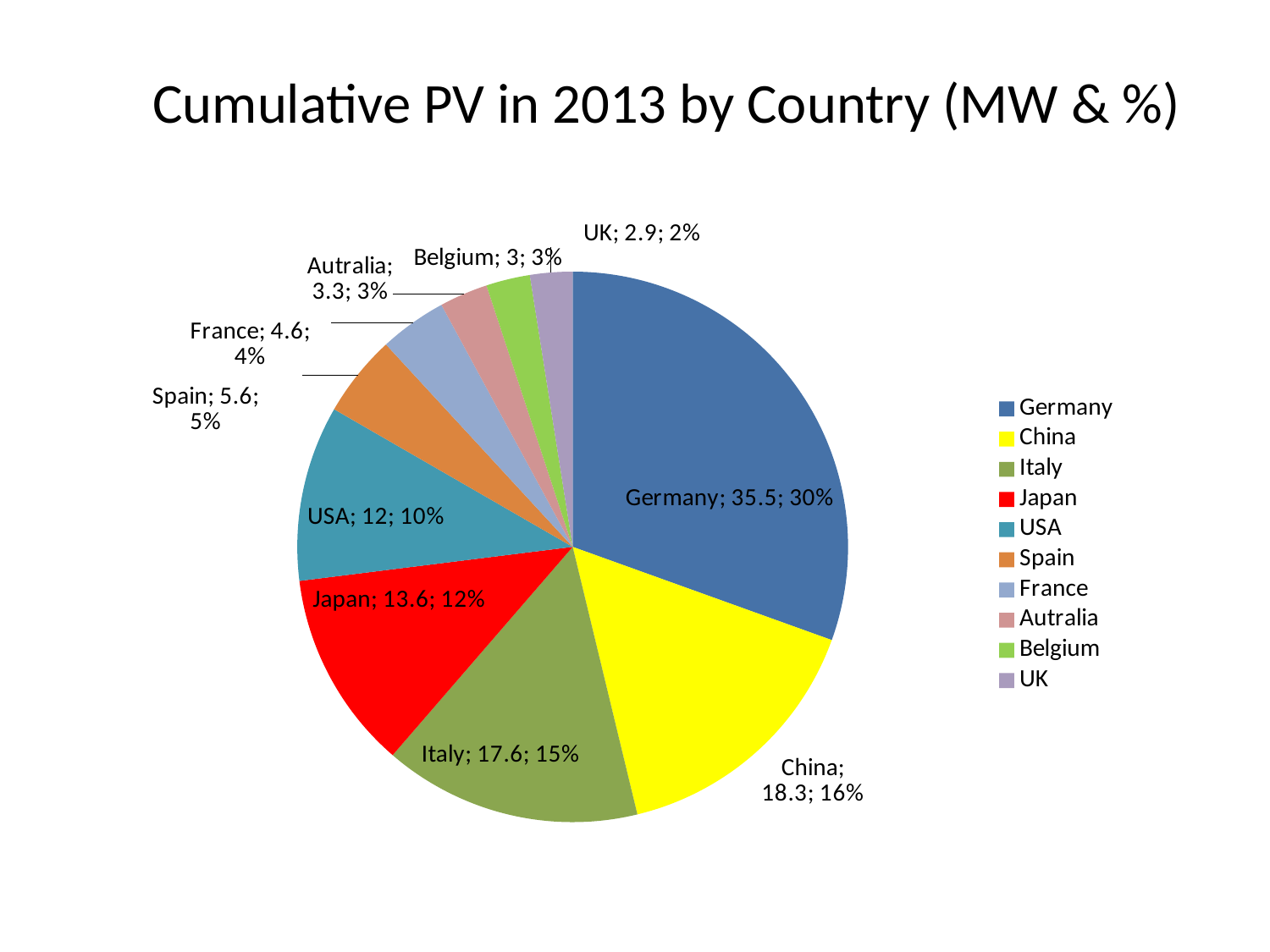
Which country has the largest slice? Germany What colour is the slice for Japan? Red What kind of chart is shown on the slide? Pie chart What percentage share does USA have? 10% What is the value for Japan? 13.6 How many countries are shown in the pie chart? 10 What percentage share does China have? 16% What is the difference between the values for Germany and China? 17.2 Which is larger, the value for Italy or the value for Japan? Italy What is the value for Germany? 35.5 What is the title of the chart? Cumulative PV in 2013 by Country (MW & %) Which country has the smallest slice? UK